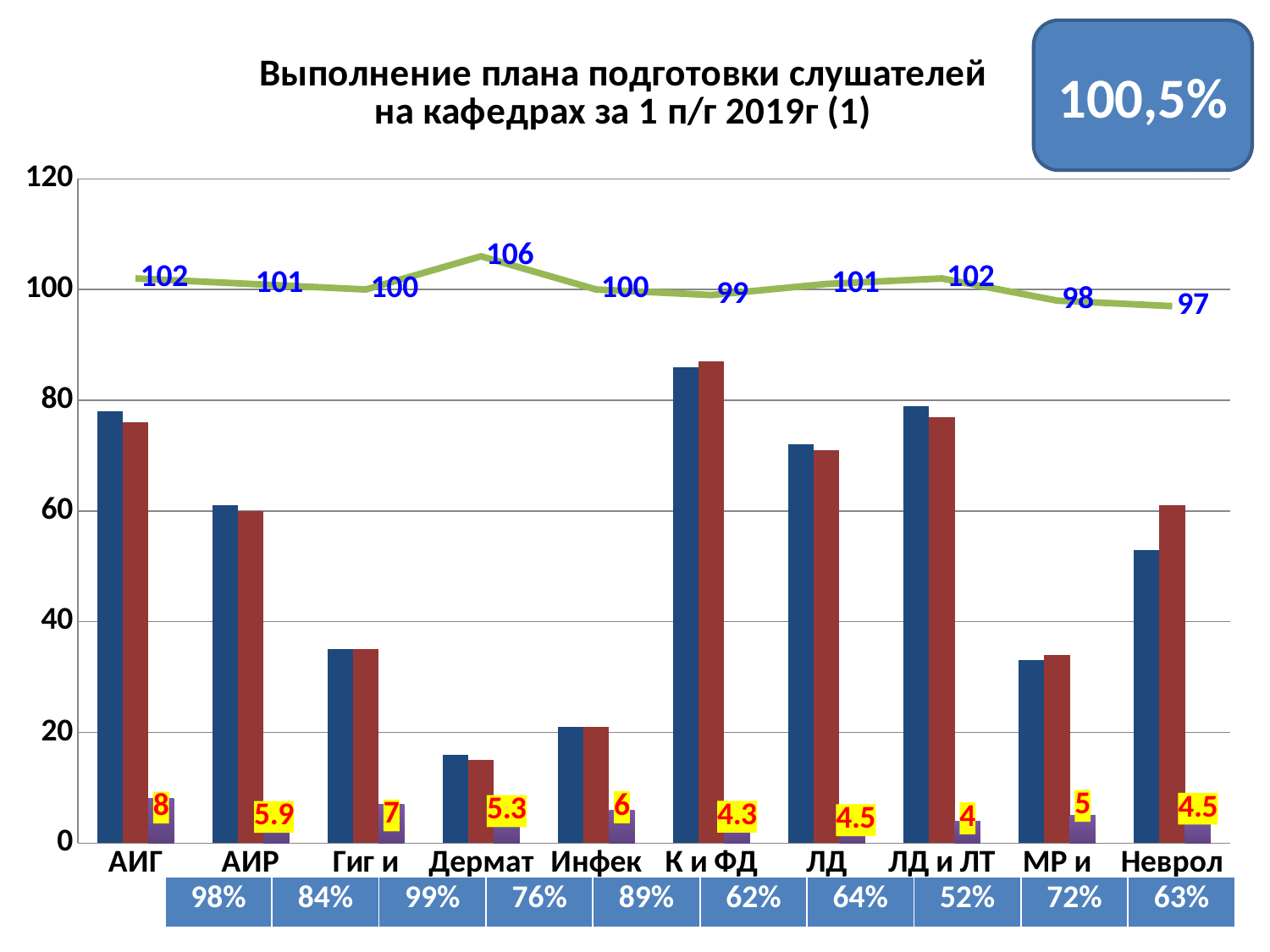
What is the value of the line series for Дермат? 106 Which category has the lowest value on the line series? Неврол Which category has the highest purple bar value? АИГ How many categories are shown on the x axis? 10 Which category has the lowest purple bar value? ЛД и ЛТ What is the difference between the line values for Дермат and Неврол? 9 Which has a taller blue bar, К и ФД or ЛД? К и ФД Is the value of the blue bar for К и ФД greater or less than 80? greater What is the value of the line series for Неврол? 97 Is the value of the blue bar for Дермат greater or less than 20? less Which category has the highest value on the line series? Дермат What is the value of the purple bar for АИР? 5.9